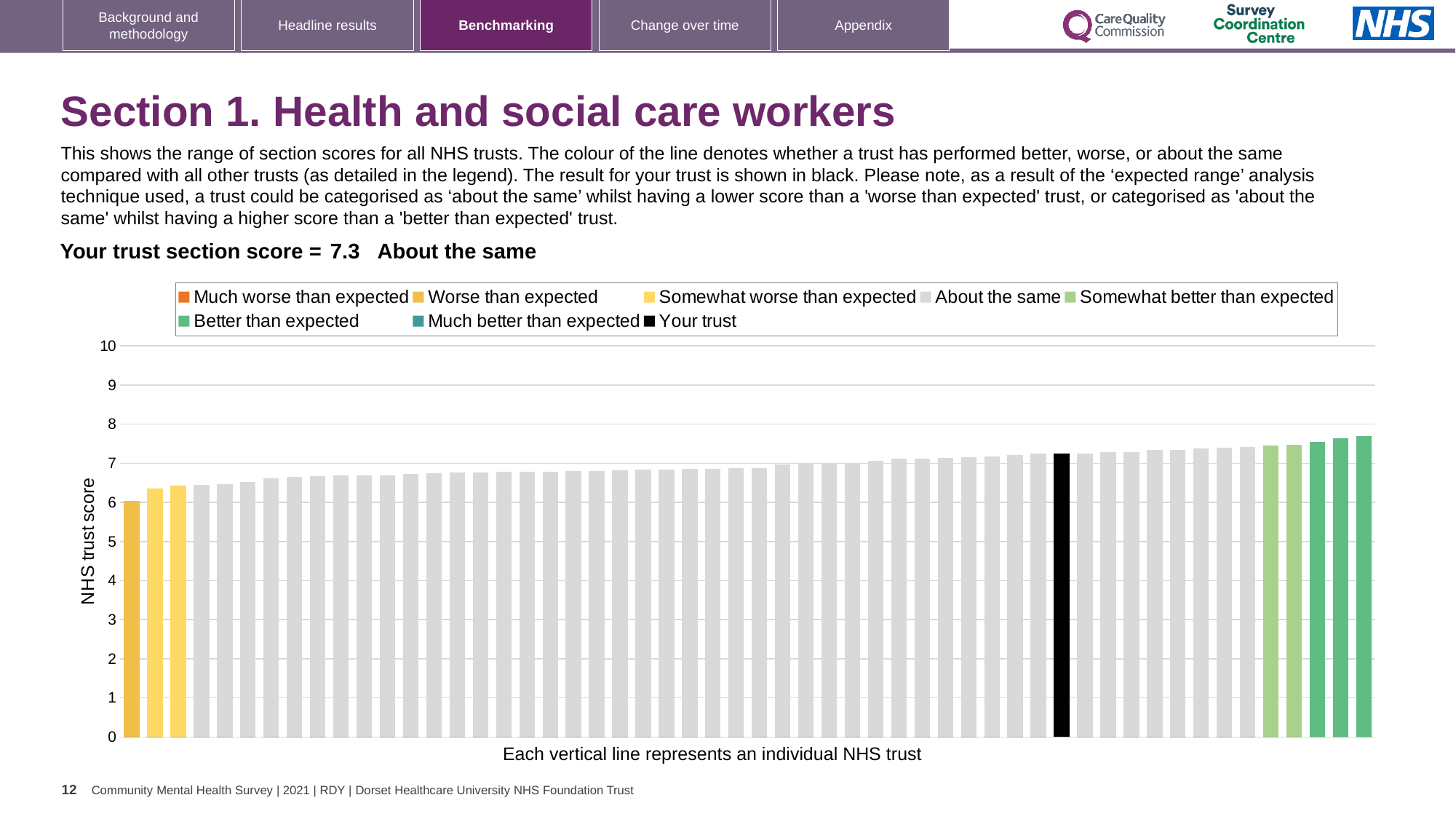
Do the bar heights rise or fall from left to right across the chart? Rise What is the label on the vertical axis of the chart? NHS trust score How many bars are coloured as 'Better than expected' (green)? 3 Is the value of the leftmost (lowest) bar greater or less than 7? less Which performance category is the trust's section score placed in? About the same What is the trust's section score shown on the slide? 7.3 How many bars are coloured as 'Worse than expected' (yellow)? 1 Is the 'Your trust' bar higher or lower than the leftmost bar? higher Is the value of the black 'Your trust' bar greater or less than 7? greater How many entries does the chart legend list? 8 What kind of chart is shown on the slide? Bar chart Is the value of the rightmost (highest) bar greater or less than 8? less